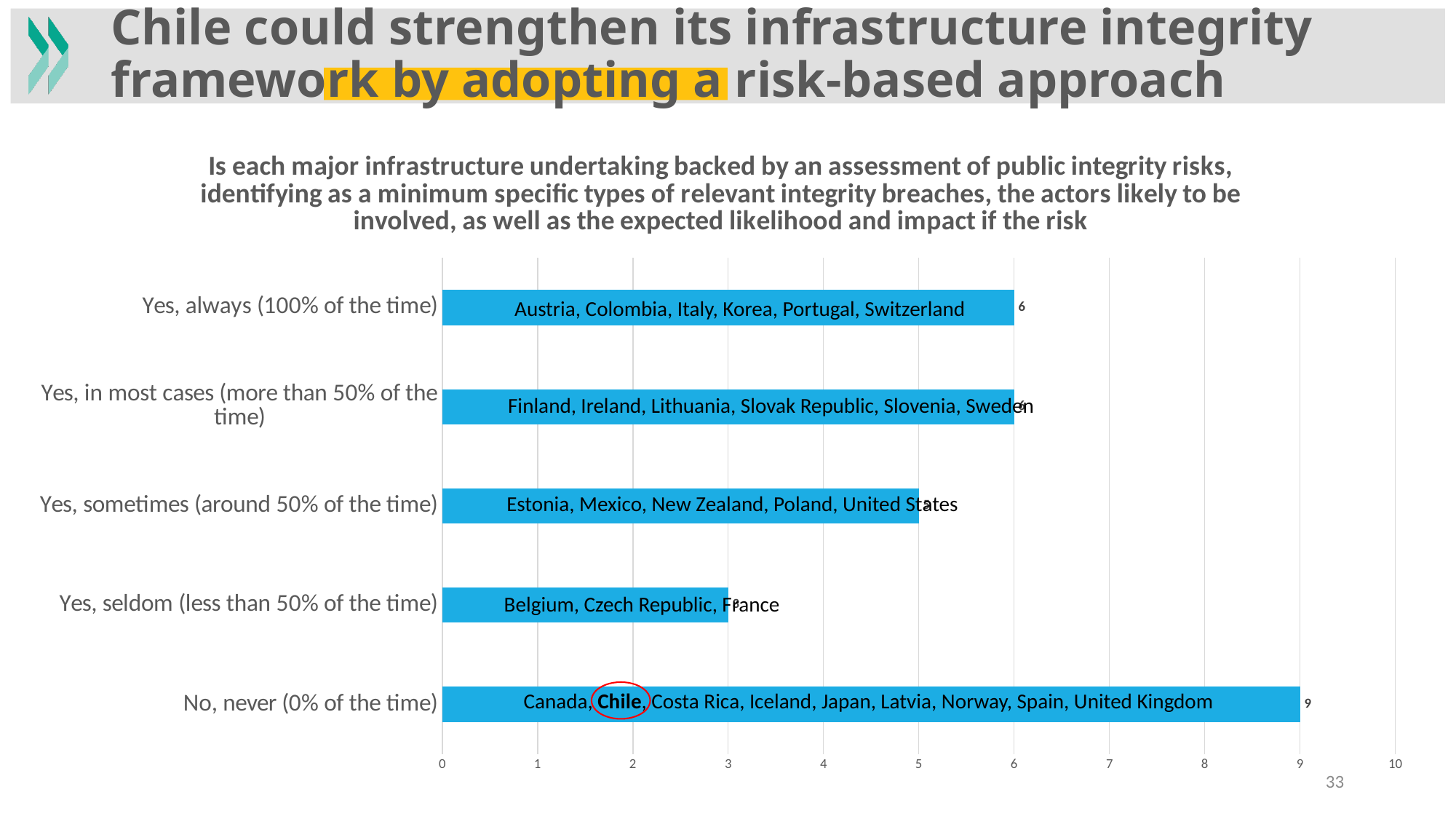
What is the value for "Yes, seldom (less than 50% of the time)"? 3 Which country is circled in the "No, never (0% of the time)" bar? Chile What is the value for "Yes, sometimes (around 50% of the time)"? 5 How many response categories are plotted in the chart? 5 What is the value for "Yes, always (100% of the time)"? 6 What type of chart is shown on the slide? bar chart What is the value for "No, never (0% of the time)"? 9 Is the value for "No, never (0% of the time)" greater or less than 8? greater Which response category has the highest value? No, never (0% of the time) Which response category has the lowest value? Yes, seldom (less than 50% of the time) Which is larger: the value for "Yes, sometimes (around 50% of the time)" or the value for "Yes, seldom (less than 50% of the time)"? Yes, sometimes (around 50% of the time) What is the difference between the value for "No, never (0% of the time)" and the value for "Yes, seldom (less than 50% of the time)"? 6